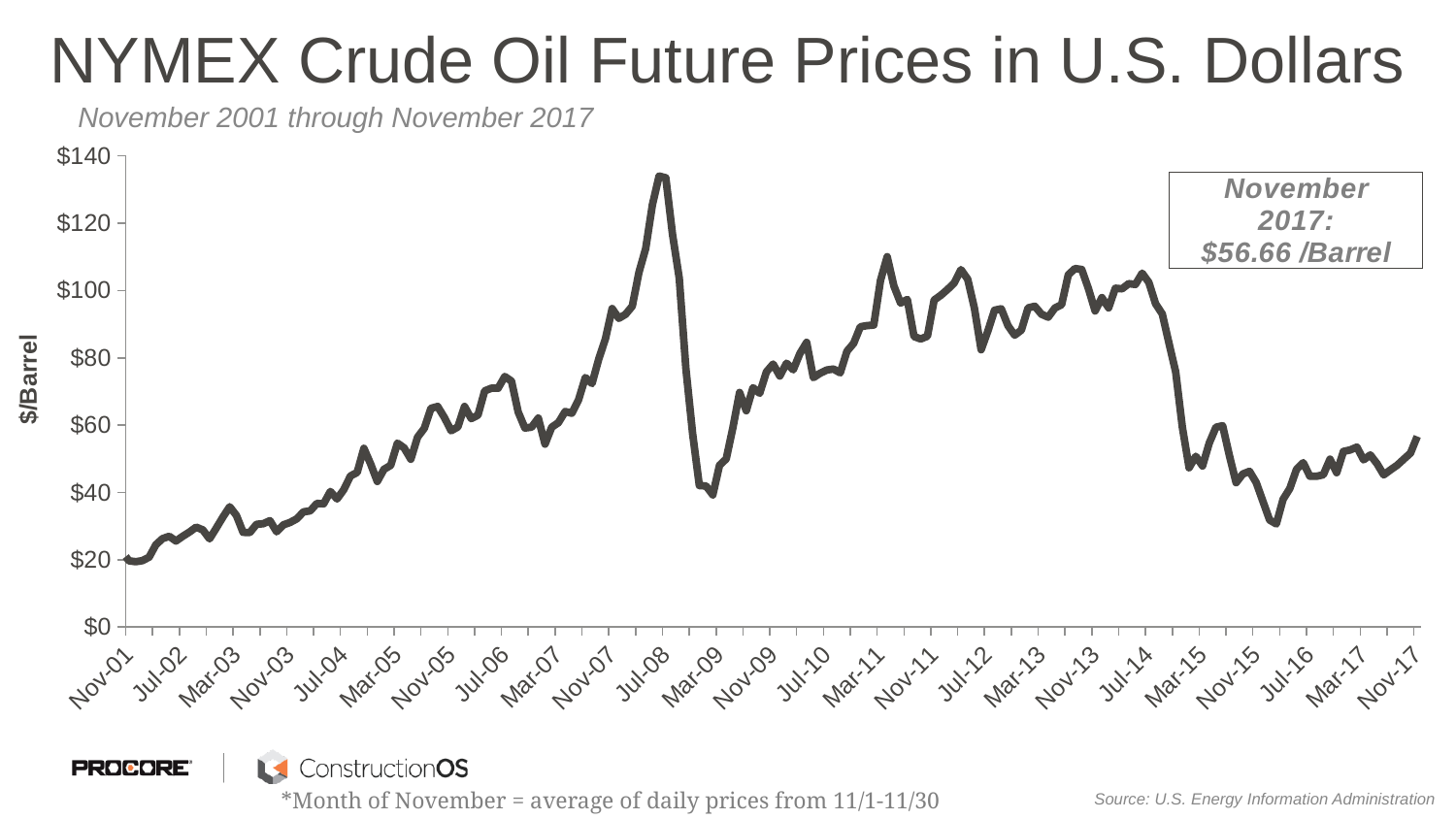
Do the values generally rise or fall from Nov-01 to Jul-08? rise Is the value at Mar-09 greater or less than $60? less Is the value at the Jul-08 peak greater or less than $120? greater What was the NYMEX crude oil future price in November 2017 according to the callout on the chart? $56.66 /Barrel What kind of chart is shown on the slide? line chart What is the label on the vertical axis of the chart? $/Barrel Around which x-axis label does the line reach its highest value? Jul-08 Which is larger, the value at Mar-11 or the value at Mar-15? Mar-11 Is the value at Nov-01 greater or less than $40? less Around which x-axis label does the line reach its lowest value? Nov-01 Do the values rise or fall from Jul-14 to Mar-15? fall